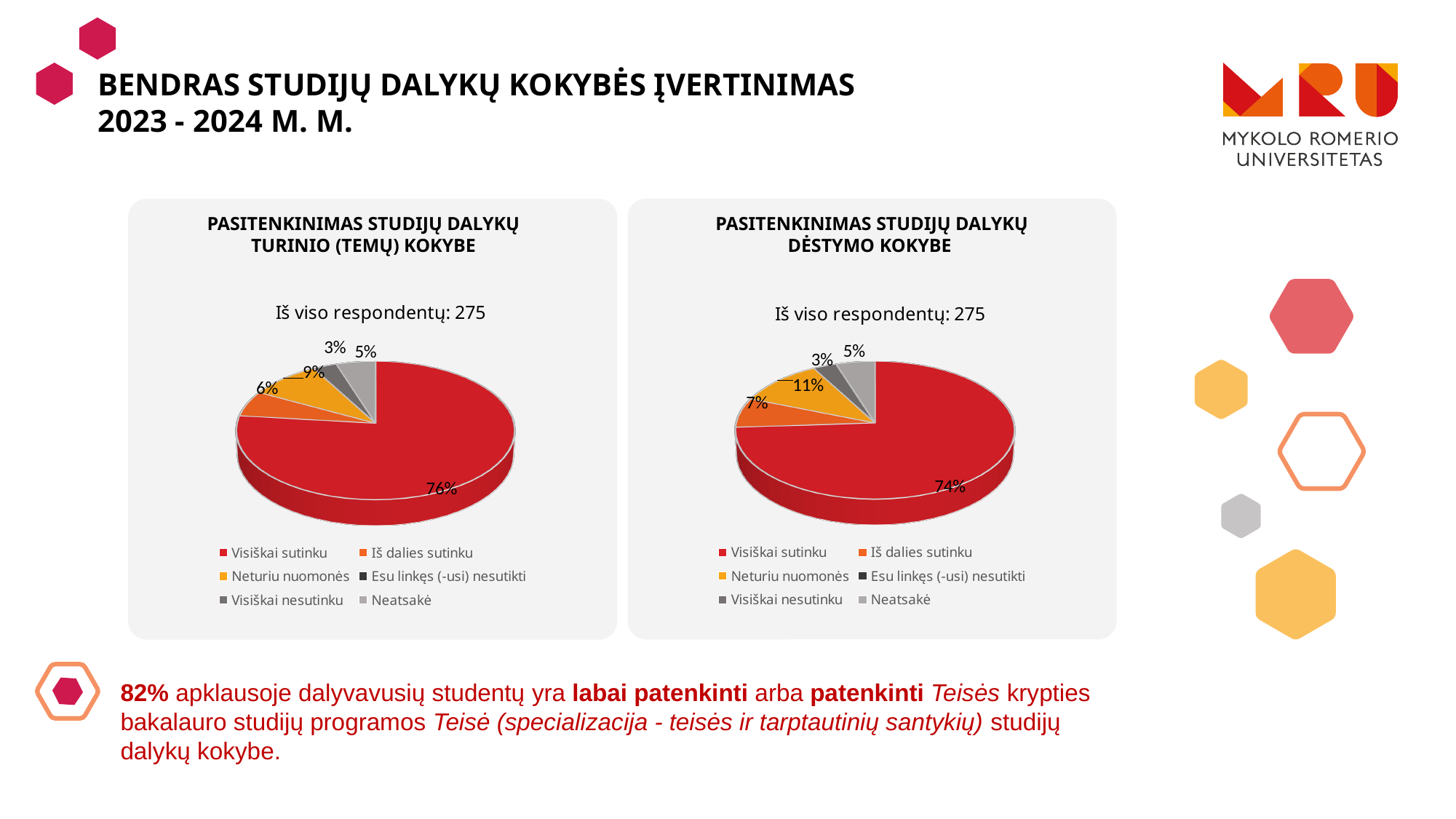
What is the difference between the Visiškai sutinku share in the left chart and in the right chart? 2 percentage points In the left chart, what percentage is shown for Neturiu nuomonės? 9% In the right chart, what percentage is shown for Neturiu nuomonės? 11% Which chart shows a larger share for Visiškai sutinku, the left one or the right one? The left one (76%) How many respondents are reported for the left chart? 275 In the left chart (Pasitenkinimas studijų dalykų turinio (temų) kokybe), what percentage is shown for Visiškai sutinku? 76% In the left chart, which category has the largest share? Visiškai sutinku In the right chart (Pasitenkinimas studijų dalykų dėstymo kokybe), what percentage is shown for Visiškai sutinku? 74% What type of chart is used on this slide? Pie chart In the left chart, what percentage is shown for Neatsakė? 5% How many entries does the legend of the right chart list? 6 In the right chart, what percentage is shown for Iš dalies sutinku? 7%